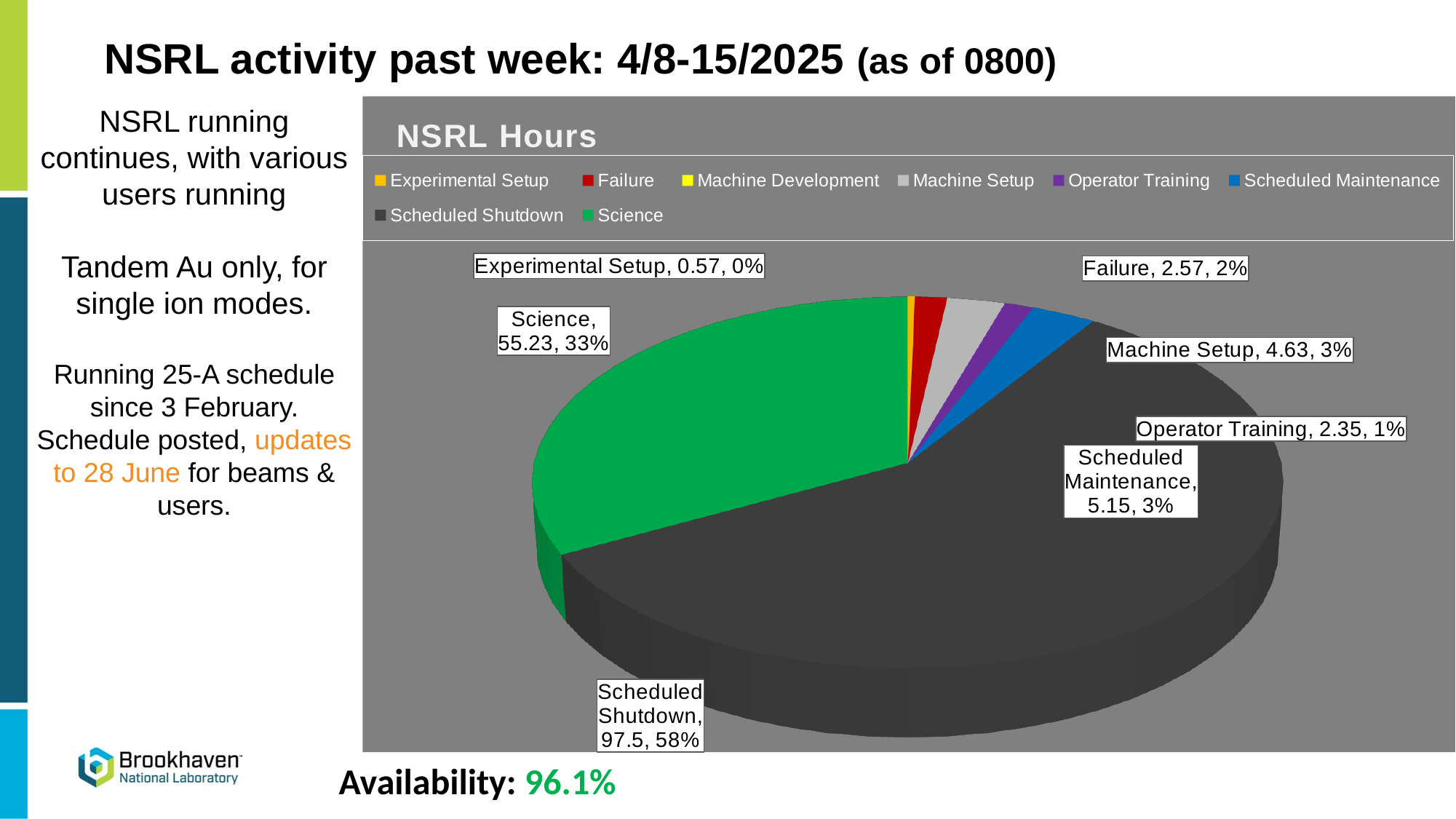
How many hours are shown for Scheduled Shutdown? 97.5 How many entries does the chart legend list? 8 How many hours are shown for Science? 55.23 What kind of chart is shown on the slide? pie chart What is the title of the chart? NSRL Hours What is the difference in hours between Scheduled Shutdown and Science? 42.27 How many hours are shown for Scheduled Maintenance? 5.15 Which category has the largest slice of the pie? Scheduled Shutdown Which has more hours, Failure or Operator Training? Failure What percentage share of the pie does Science have? 33% How many hours are shown for Machine Setup? 4.63 What percentage share of the pie does Scheduled Shutdown have? 58%